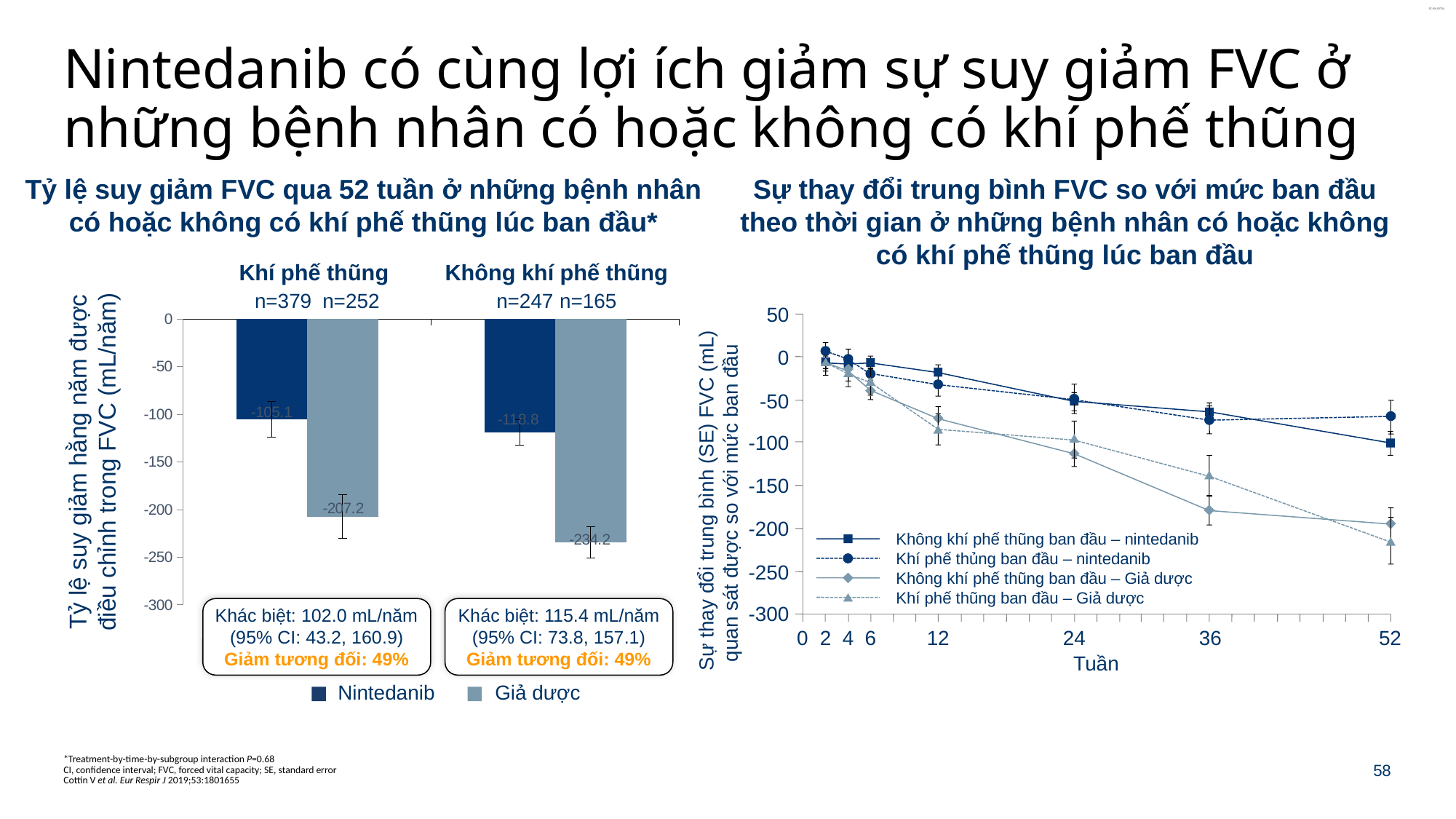
What type of chart is the left chart? Bar chart In the left chart, what is the value for Giả dược in the Khí phế thũng group? -207.2 How many series does the legend of the right chart list? 4 In the left chart, what relative reduction (Giảm tương đối) is shown for the Khí phế thũng group? 49% In the left chart, how many patients (n) are in the Nintedanib arm of the Khí phế thũng group? n=379 In the right chart, at week 52, is the value for 'Không khí phế thũng ban đầu – Giả dược' greater or less than -150? less In the left chart, what is the annual rate of FVC decline for Nintedanib in the Khí phế thũng group? -105.1 In the left chart, which bar shows the largest FVC decline (most negative value)? Giả dược, Không khí phế thũng (-234.2) In the right chart, do the FVC change values rise or fall over the weeks? Fall In the left chart, what is the annual rate of FVC decline for Giả dược in the Không khí phế thũng group? -234.2 In the right chart, at week 52, which is higher: 'Khí phế thủng ban đầu – nintedanib' or 'Khí phế thũng ban đầu – Giả dược'? Khí phế thủng ban đầu – nintedanib In the left chart, what is the stated difference (Khác biệt) between Nintedanib and Giả dược in the Không khí phế thũng group? 115.4 mL/năm